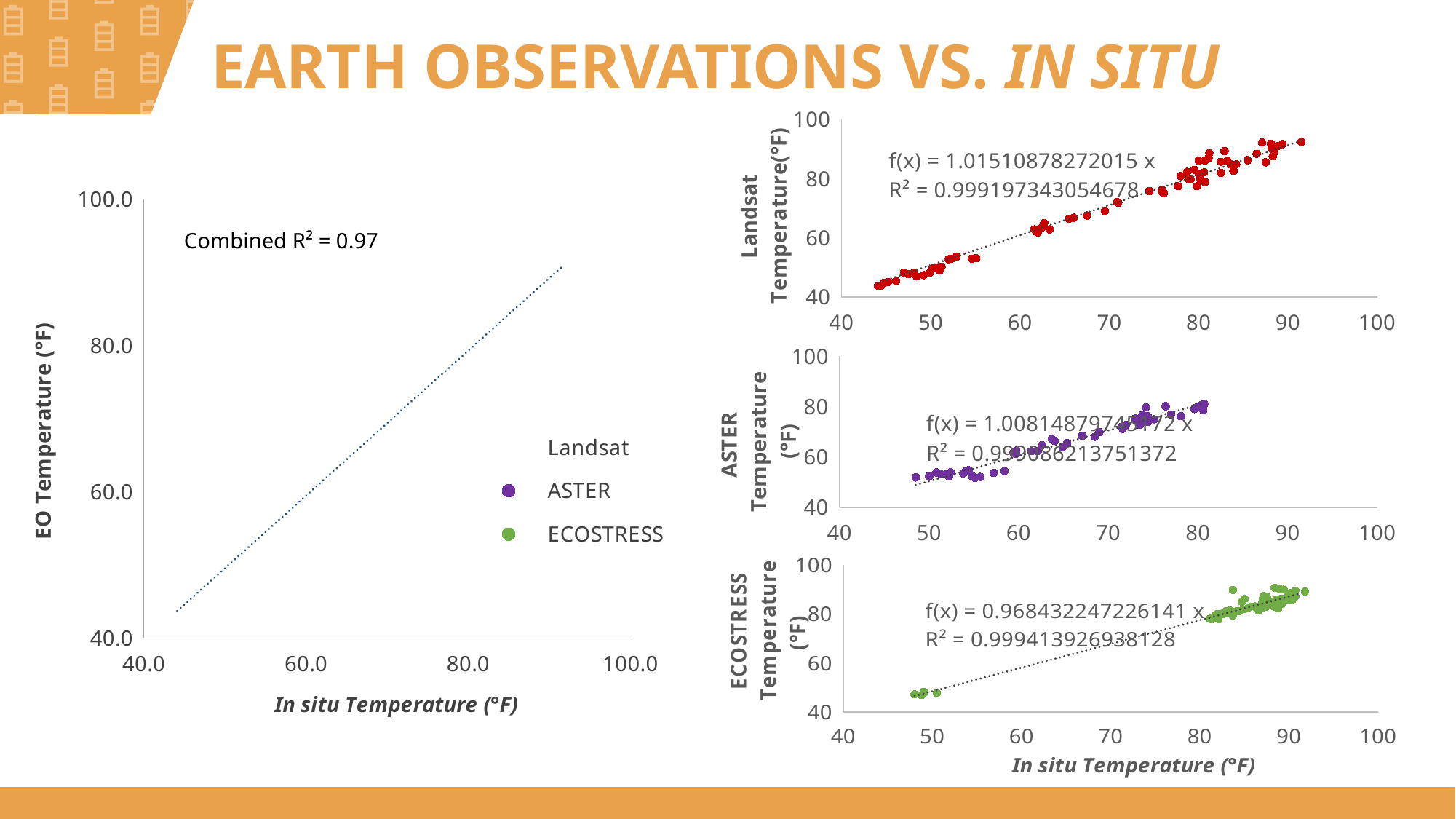
What kind of chart is the large chart on the left of the slide? scatter chart In the Landsat Temperature chart (top right), what is the R² value shown? 0.999197343054678 What colour are the ASTER points in the legend of the large left chart? purple What is the combined R² value shown on the large left chart? 0.97 In the Landsat Temperature chart (top right), do the plotted points rise or fall as in situ temperature increases? rise Is the fitted-line slope larger in the Landsat chart or in the ECOSTRESS chart? Landsat In the Landsat Temperature chart (top right), what is the slope of the fitted line f(x)? 1.01510878272015 Which of the three small charts on the right has a fitted-line slope less than 1? ECOSTRESS In the ECOSTRESS Temperature chart (bottom right), is the ECOSTRESS temperature of the cluster of points near 50 on the x axis greater or less than 60? less How many series does the legend of the large left chart list? 3 In the ECOSTRESS Temperature chart (bottom right), what is the slope of the fitted line f(x)? 0.968432247226141 In the ECOSTRESS Temperature chart (bottom right), what is the R² value shown? 0.999413926938128